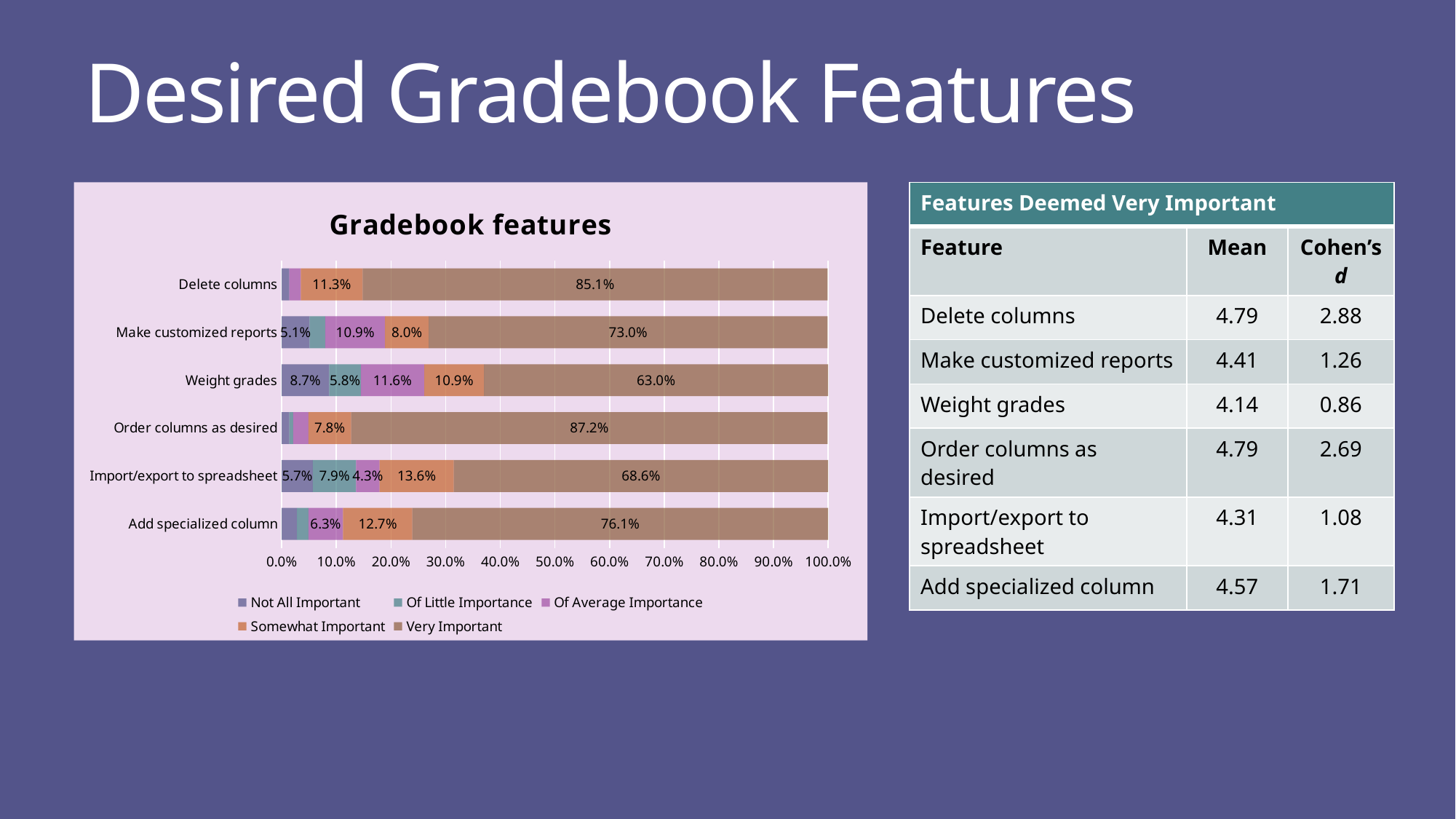
Which feature has the lowest Very Important percentage? Weight grades How many gradebook features (categories) are plotted in the chart? 6 What is the title of the chart? Gradebook features Which has a larger Very Important percentage: 'Make customized reports' or 'Add specialized column'? Add specialized column What type of chart is shown on the slide? Stacked bar chart What is the Somewhat Important value for 'Import/export to spreadsheet'? 13.6% What is the Of Average Importance value for 'Weight grades'? 11.6% How many series does the chart legend list? 5 Which feature has the highest Very Important percentage? Order columns as desired What is the difference between the Very Important percentages for 'Order columns as desired' and 'Weight grades'? 24.2 percentage points Which series is shown in orange in the chart legend? Somewhat Important What percentage of respondents rated 'Delete columns' as Very Important? 85.1%